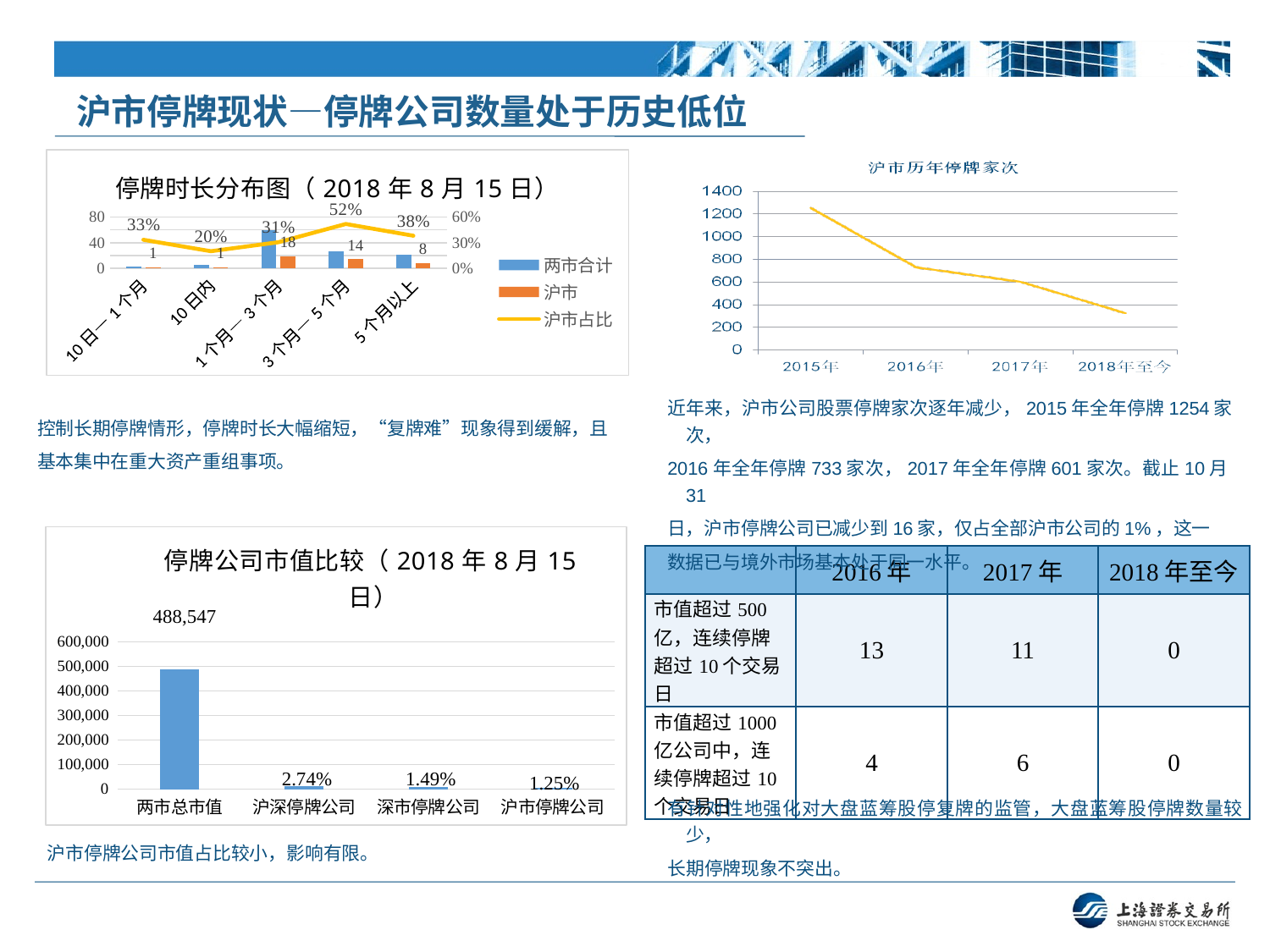
In the 沪市历年停牌家次 chart, is the value for 2015年 greater or less than 1000? greater In the 停牌公司市值比较 chart, what is the value for 两市总市值? 488,547 How many series does the legend of the 停牌时长分布图 chart list? 3 In the 停牌时长分布图 chart, what is the 沪市占比 value for 3个月—5个月? 52% What kind of chart is the 沪市历年停牌家次 chart? line chart How many points are plotted in the 沪市历年停牌家次 chart? 4 In the 沪市历年停牌家次 chart, is the value for 2018年至今 greater or less than 400? less In the 停牌公司市值比较 chart, what is the value labelled for 沪市停牌公司? 1.25% In the 沪市历年停牌家次 chart, do the values rise or fall from 2015年 to 2018年至今? fall In the 停牌时长分布图 chart, what is the difference between the 沪市 values for 1个月—3个月 and 3个月—5个月? 4 In the 停牌时长分布图 chart, what is the 沪市 value for 1个月—3个月? 18 In the 停牌时长分布图 chart, which category has the highest 沪市占比? 3个月—5个月